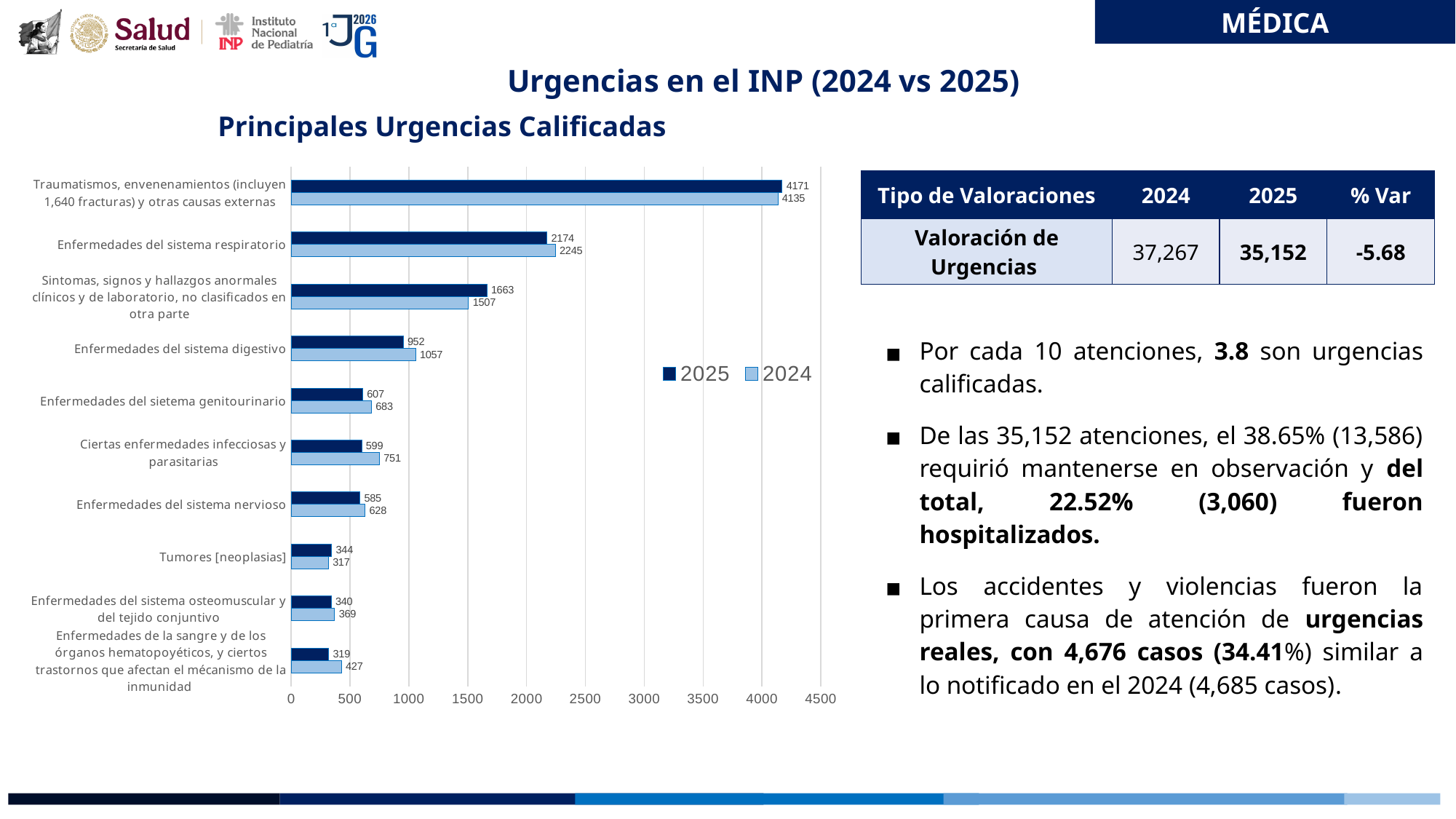
What is the 2024 value for Enfermedades del sistema digestivo? 1057 What is the 2025 value for Tumores [neoplasias]? 344 Is the 2025 value for Síntomas, signos y hallazgos anormales clínicos y de laboratorio, no clasificados en otra parte greater or less than 1500? greater For Enfermedades del sistema nervioso, which year has the larger value, 2024 or 2025? 2024 Which category has the lowest 2024 value? Tumores [neoplasias] What is the title of the chart? Principales Urgencias Calificadas What kind of chart is shown on the slide? Bar chart Which category has the highest 2025 value? Traumatismos, envenenamientos (incluyen 1,640 fracturas) y otras causas externas How many categories are shown on the chart? 10 What is the 2025 value for Enfermedades del sistema respiratorio? 2174 What is the difference between the 2024 and 2025 values for Ciertas enfermedades infecciosas y parasitarias? 152 How many series does the legend list? 2